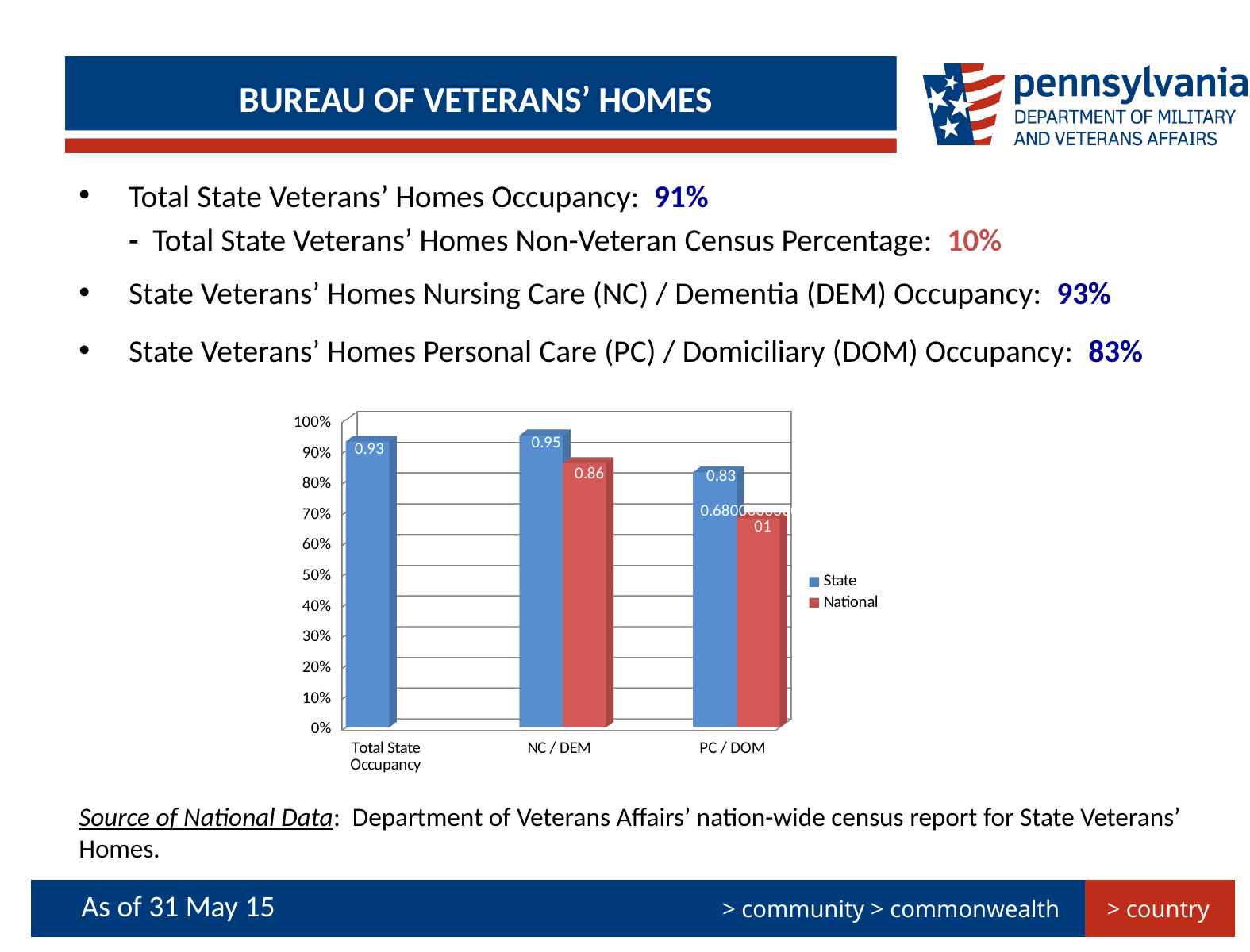
What is the difference between the State and National values for NC / DEM? 0.09 For PC / DOM, which is larger, the State value or the National value? State What is the National value for NC / DEM? 0.86 What kind of chart is shown on the slide? bar chart What is the State value for PC / DOM? 0.83 Which category has the highest State value? NC / DEM How many categories are shown on the x axis? 3 How many series does the legend list? 2 Is the National value for PC / DOM greater or less than 80%? less Which category has the lowest State value? PC / DOM What is the State value for NC / DEM? 0.95 What is the State value for Total State Occupancy? 0.93